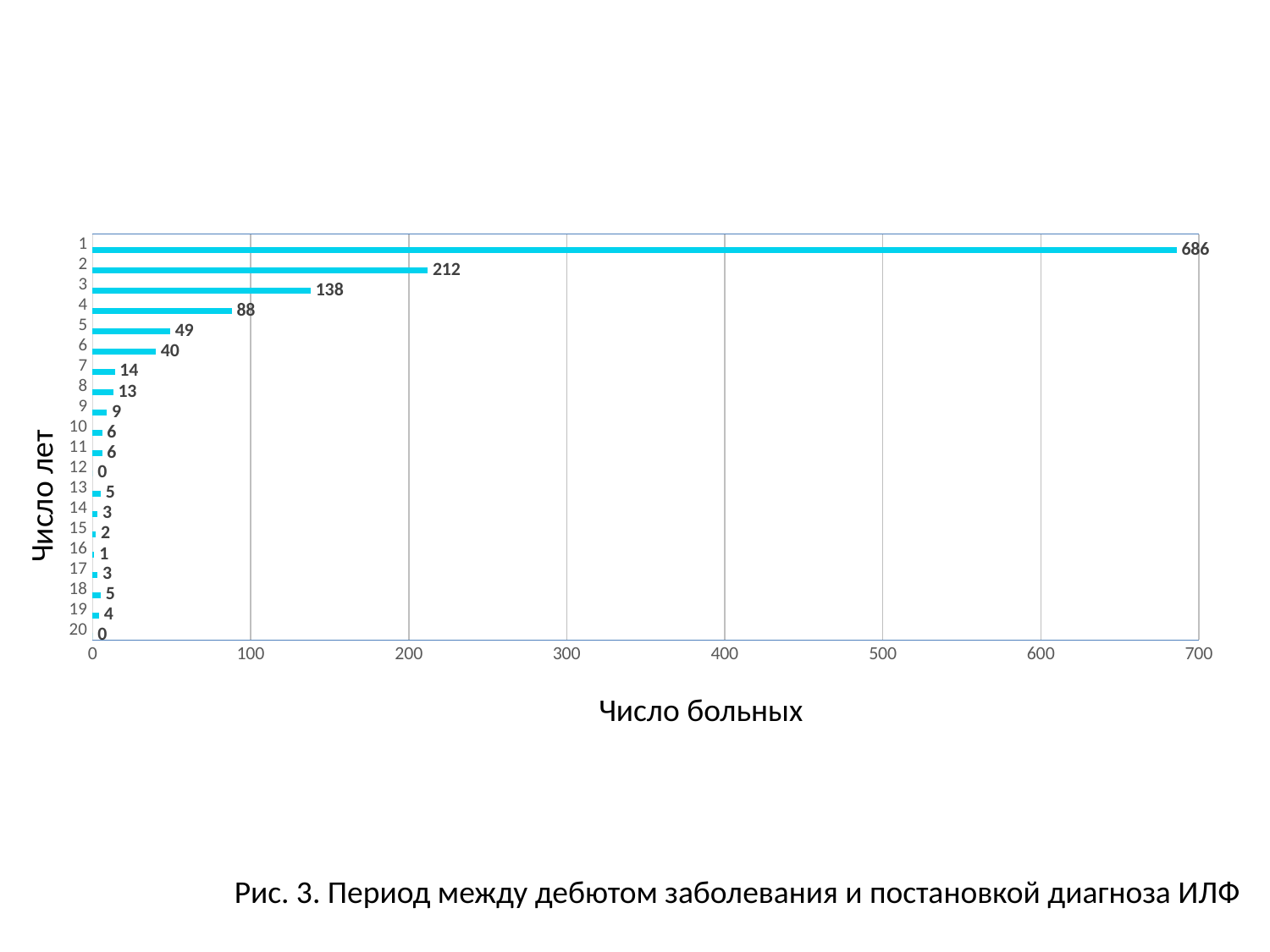
Which has more patients: 7 years or 8 years? 7 years What kind of chart is shown on the slide? Bar chart Is the value for 2 years greater or less than 200? greater What is the number of patients for 3 years? 138 What is the difference between the number of patients for 1 year and for 2 years? 474 How many categories (years) are shown on the y axis? 20 Which categories have a value of 0? 12 and 20 What is the number of patients (Число больных) for 1 year? 686 What is the number of patients for 6 years? 40 What is the difference between the number of patients for 4 years and for 5 years? 39 What is the label of the x axis? Число больных Which number of years has the highest number of patients? 1